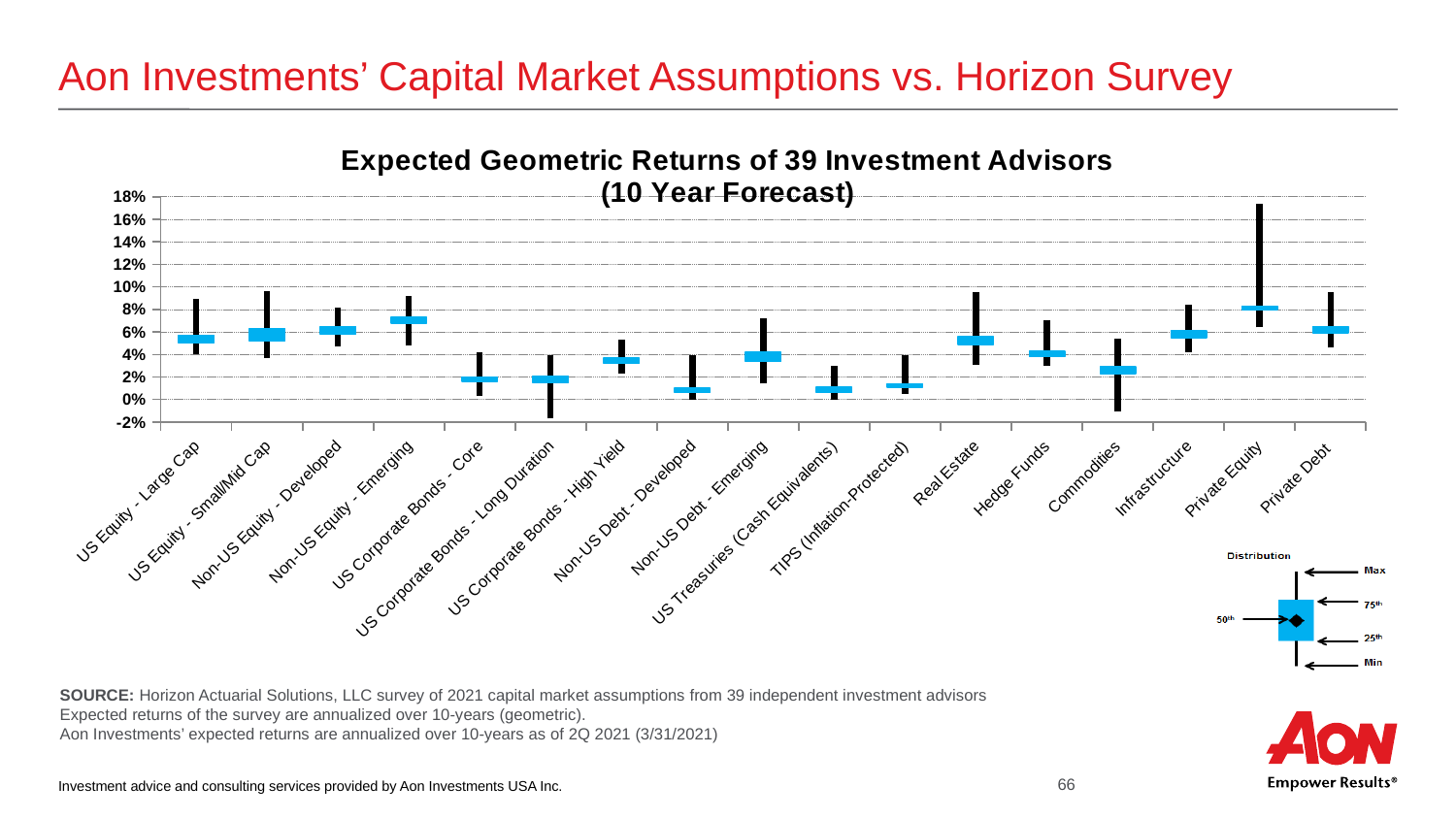
How many asset classes are plotted along the x axis of the chart? 17 Which asset class has the highest maximum expected return in the chart? Private Equity What kind of chart is shown on the slide? box-and-whisker chart Which asset class has the lowest minimum expected return in the chart? US Corporate Bonds - Long Duration Is the minimum expected return for US Corporate Bonds - Long Duration greater or less than 0%? less Is the median (50th percentile) expected return for Commodities greater or less than 4%? less What is the highest value shown on the chart's y axis? 18% Is the median expected return for Non-US Equity - Emerging greater or less than 6%? greater Which has the higher median expected return, Private Equity or Commodities? Private Equity What is the title of the chart? Expected Geometric Returns of 39 Investment Advisors (10 Year Forecast) Which has the higher median expected return, Non-US Equity - Emerging or US Corporate Bonds - Core? Non-US Equity - Emerging